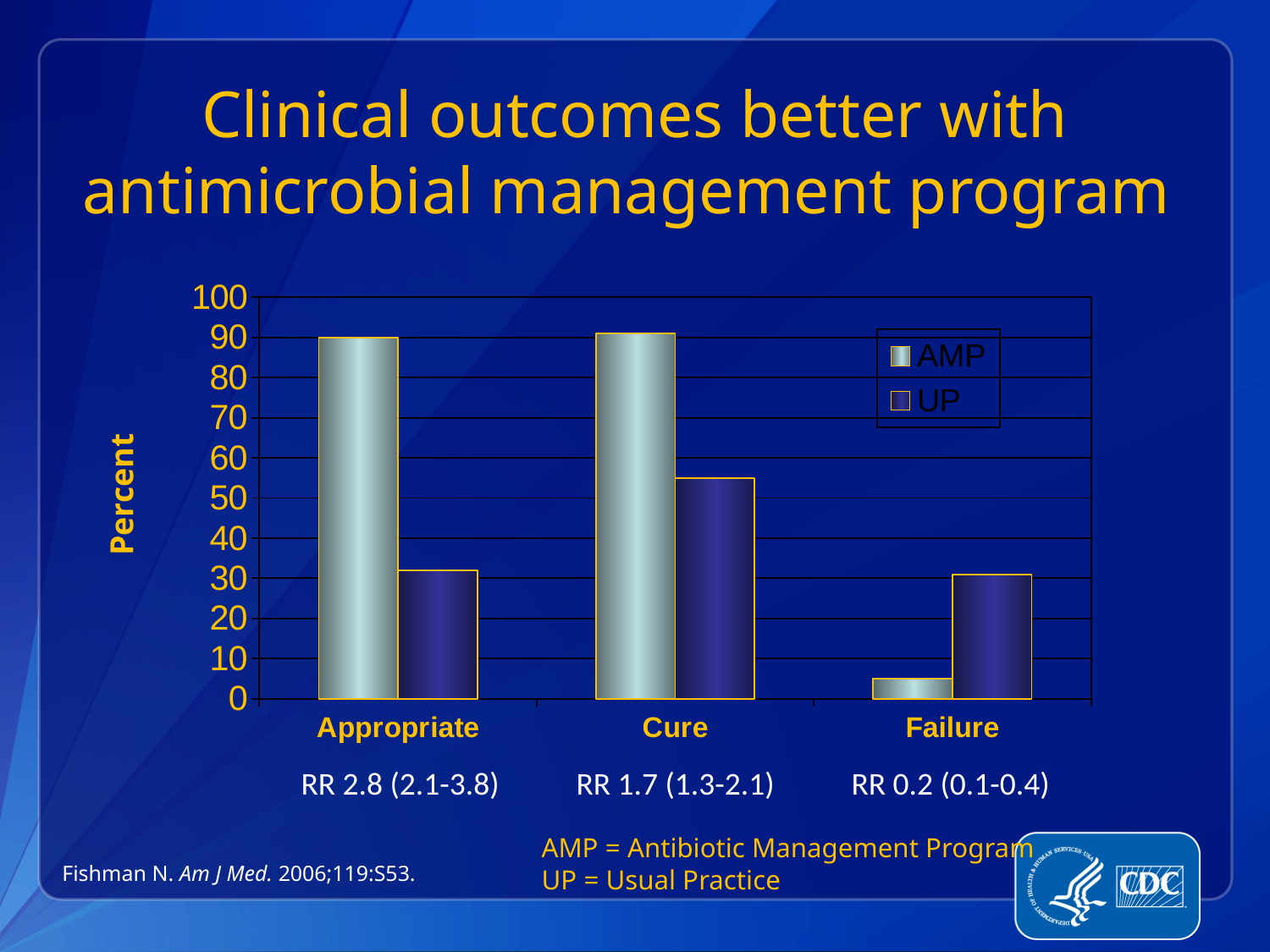
Which is larger for Cure, the AMP value or the UP value? AMP What is the label on the y axis? Percent Is the UP value for Cure greater or less than 50? greater What kind of chart is shown on the slide? bar chart Which category has the lowest AMP value? Failure Is the AMP value for Failure greater or less than 10? less Which is larger for Failure, the AMP value or the UP value? UP What are the two series named in the legend? AMP and UP Is the UP value for Appropriate greater or less than 40? less How many categories are shown on the x axis? 3 How many series does the legend list? 2